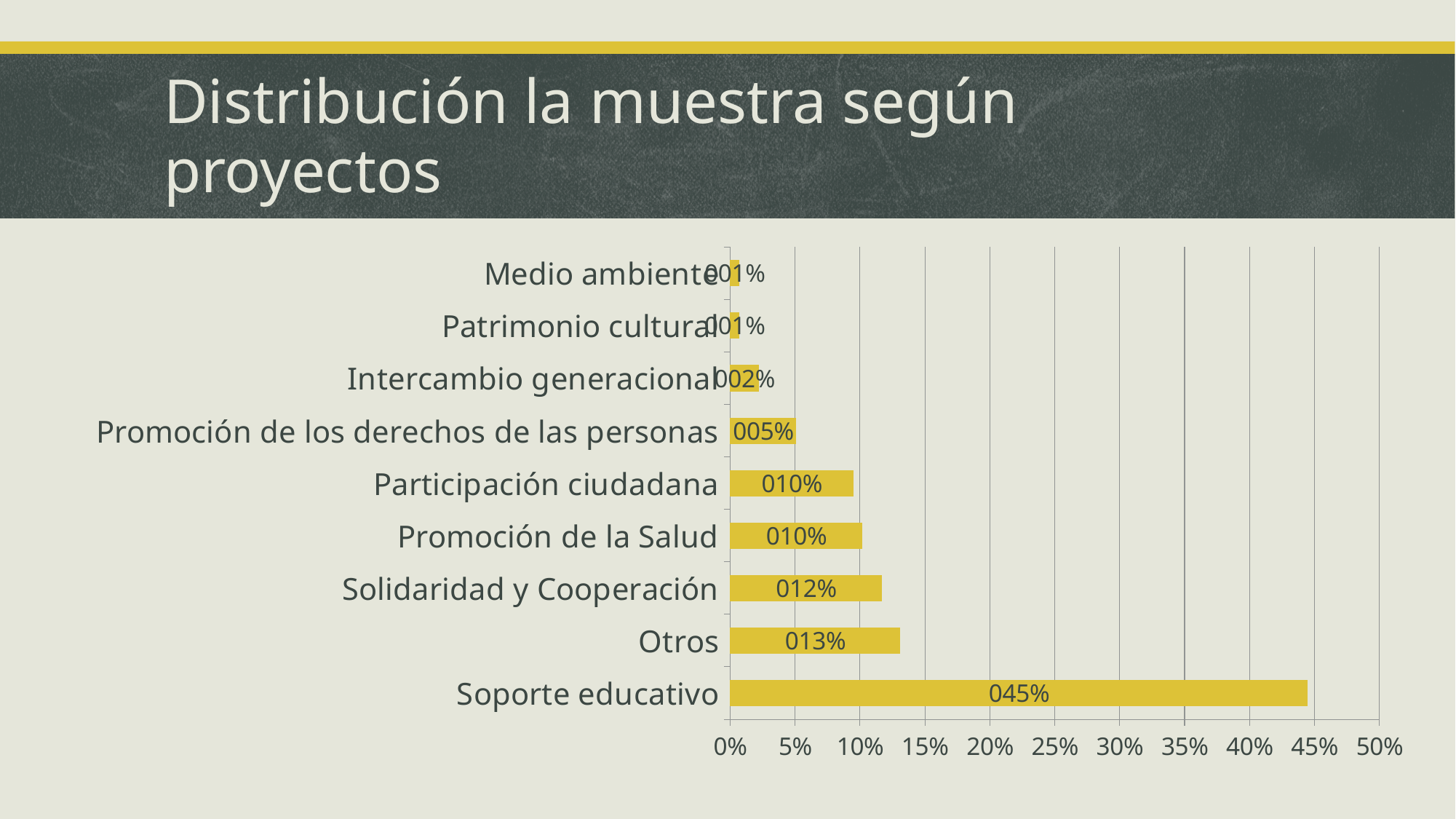
What is the value for Solidaridad y Cooperación? 012% What is the value for Soporte educativo? 045% What is the value for Promoción de los derechos de las personas? 005% What is the difference between the values for Soporte educativo and Otros? 32% Which is larger, the value for Soporte educativo or the value for Solidaridad y Cooperación? Soporte educativo What is the value for Otros? 013% Is the value for Soporte educativo greater or less than 40%? greater What is the title of the slide? Distribución la muestra según proyectos What is the value for Participación ciudadana? 010% How many categories are shown in the chart? 9 Which category has the highest value? Soporte educativo What kind of chart is shown on the slide? bar chart